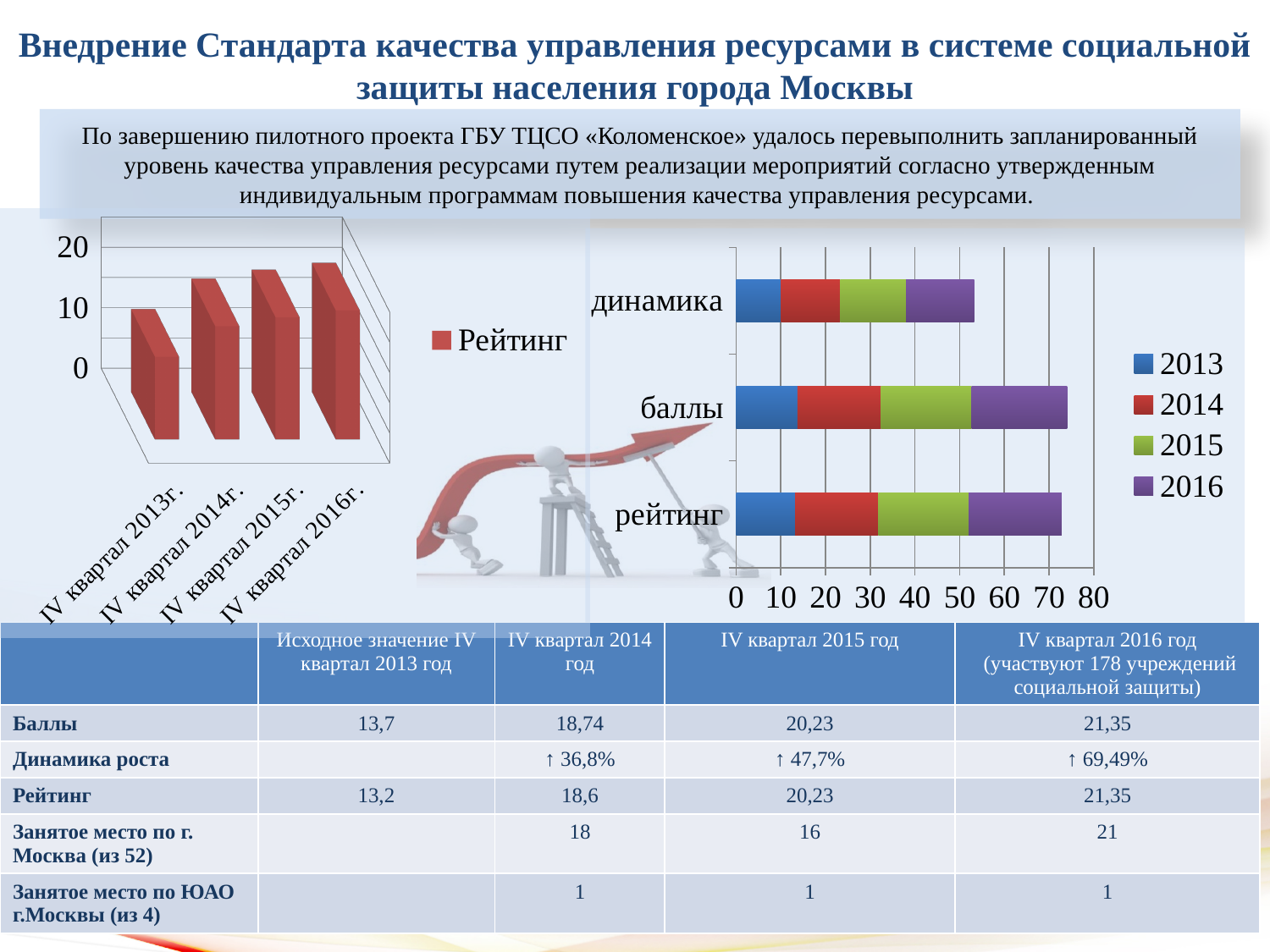
How many bars does the left chart with the legend 'Рейтинг' show? 4 In the left chart with the legend 'Рейтинг', is the value for IV квартал 2013г. greater or less than 20? less In the left chart with the legend 'Рейтинг', which quarter has the lowest bar? IV квартал 2013г. In the left chart with the legend 'Рейтинг', which is larger: the bar for IV квартал 2013г. or the bar for IV квартал 2014г.? IV квартал 2014г. How many series does the legend of the right stacked bar chart list? 4 In the right stacked bar chart, which category has the shortest total bar? динамика In the left chart with the legend 'Рейтинг', do the values rise or fall from IV квартал 2013г. to IV квартал 2016г.? rise In the right stacked bar chart, which colour represents the 2016 series? purple How many categories does the right stacked bar chart show? 3 In the right stacked bar chart, is the total bar for 'динамика' greater or less than 60? less What kind of chart is the left chart with the legend 'Рейтинг'? bar chart In the left chart with the legend 'Рейтинг', which quarter has the highest bar? IV квартал 2016г.